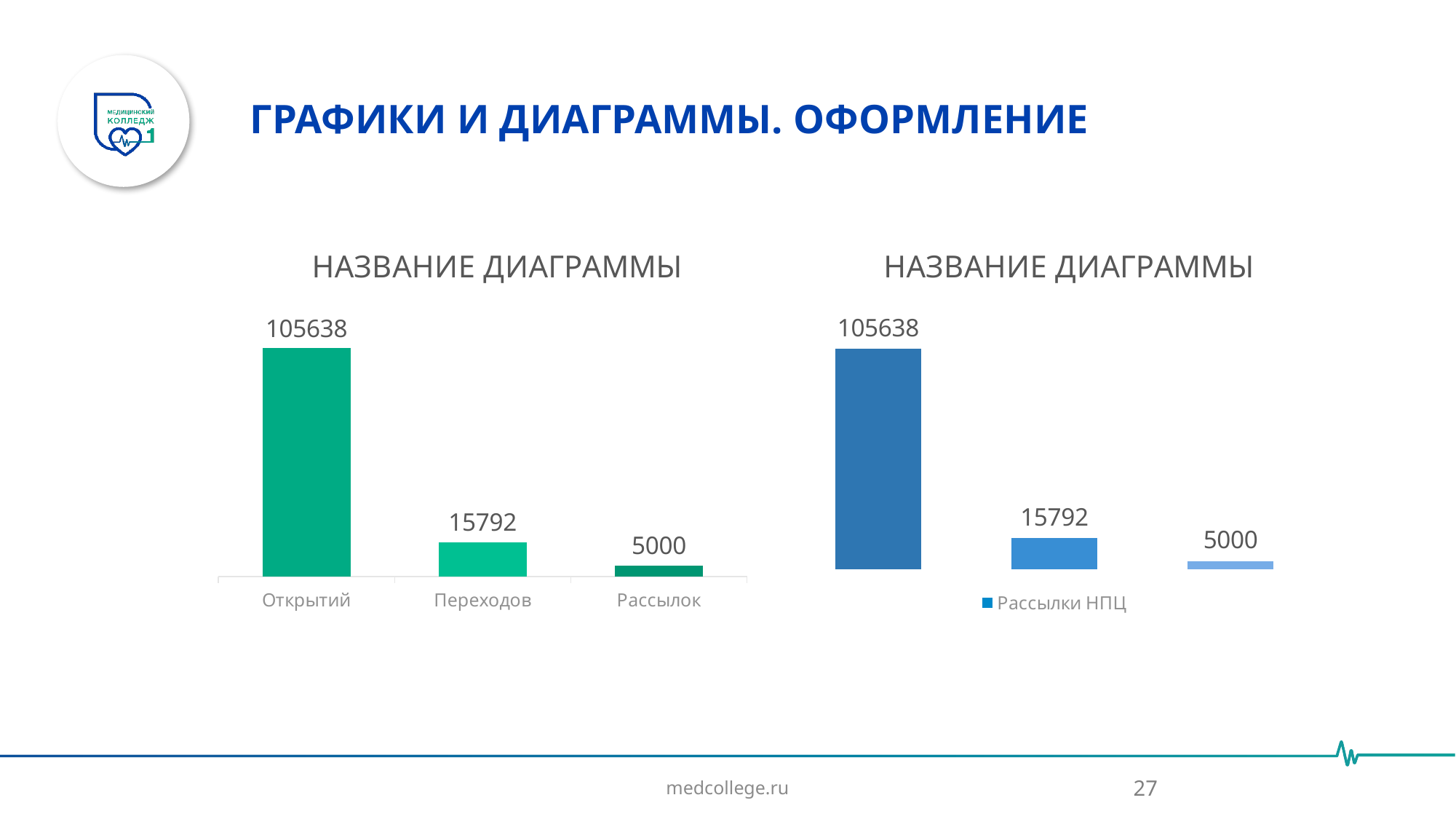
In the left chart, which category has the highest value? Открытий In the left chart, what is the value for Рассылок? 5000 What series name does the legend of the right chart show? Рассылки НПЦ In the left chart, which is larger: the value for Переходов or the value for Рассылок? Переходов In the left chart, which category has the lowest value? Рассылок How many bars does the left chart have? 3 In the left chart, what is the value for Открытий? 105638 What type of chart is the right chart? bar chart In the right chart, what is the value of the tallest bar? 105638 In the left chart, what is the difference between the values for Переходов and Рассылок? 10792 In the left chart, what is the difference between the values for Открытий and Переходов? 89846 In the left chart, what is the value for Переходов? 15792